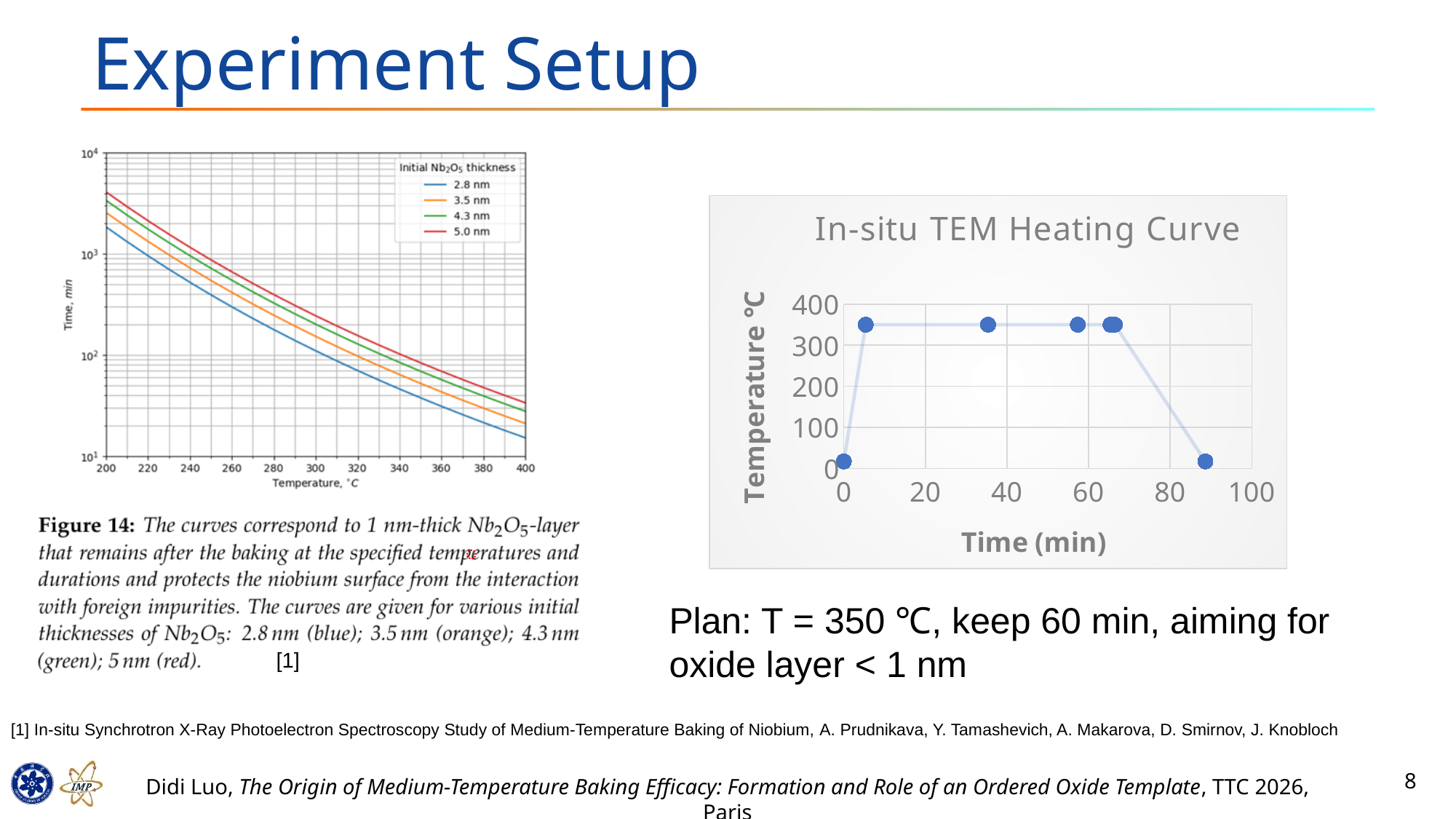
In the In-situ TEM Heating Curve chart, what is the label of the x axis? Time (min) What is the title of the chart on the right side of the slide? In-situ TEM Heating Curve In the In-situ TEM Heating Curve chart, is the temperature of the plateau between about 5 and 65 min greater or less than 300? greater How many series does the legend of the Figure 14 chart on the left list? 4 What kind of chart is the In-situ TEM Heating Curve? line chart In the Figure 14 chart on the left, which initial Nb2O5 thickness has the highest curve? 5.0 nm In the Figure 14 chart on the left, which initial Nb2O5 thickness has the lowest curve? 2.8 nm In the Figure 14 chart on the left, at 400 °C is the time for the 2.8 nm curve greater or less than 10^2 min? less In the In-situ TEM Heating Curve chart, is the temperature at time 0 greater or less than 100? less In the In-situ TEM Heating Curve chart, does the temperature rise or fall between the last two points (from about 65 min to about 90 min)? fall What kind of chart is Figure 14 on the left of the slide? line chart In the Figure 14 chart on the left, do the curves rise or fall as temperature increases along the x axis? fall